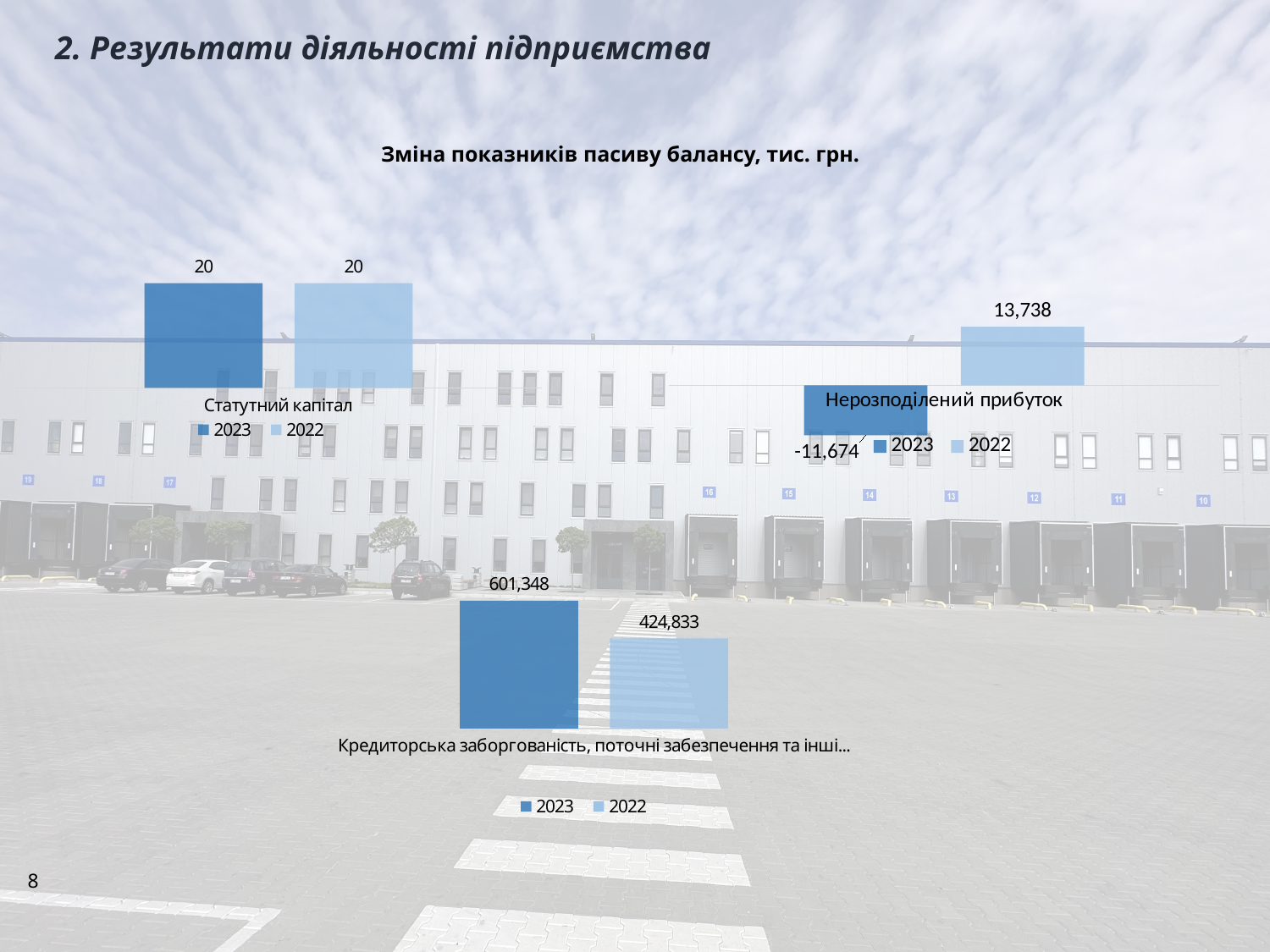
In the 'Статутний капітал' chart, what is the value for 2023? 20 In the 'Кредиторська заборгованість, поточні забезпечення та інші...' chart, what is the value for 2022? 424,833 How many series does the legend of the 'Статутний капітал' chart list? 2 In the 'Кредиторська заборгованість, поточні забезпечення та інші...' chart, which year has the higher value, 2023 or 2022? 2023 In the 'Статутний капітал' chart, what is the value for 2022? 20 What is the overall title above the charts on the slide? Зміна показників пасиву балансу, тис. грн. In the 'Кредиторська заборгованість, поточні забезпечення та інші...' chart, what is the difference between the 2023 and 2022 values? 176,515 In the 'Нерозподілений прибуток' chart, which year has the lower value? 2023 In the 'Нерозподілений прибуток' chart, what is the value for 2022? 13,738 In the 'Кредиторська заборгованість, поточні забезпечення та інші...' chart, what is the value for 2023? 601,348 In the 'Нерозподілений прибуток' chart, what is the value for 2023? -11,674 What type of chart is the 'Нерозподілений прибуток' chart? Bar chart